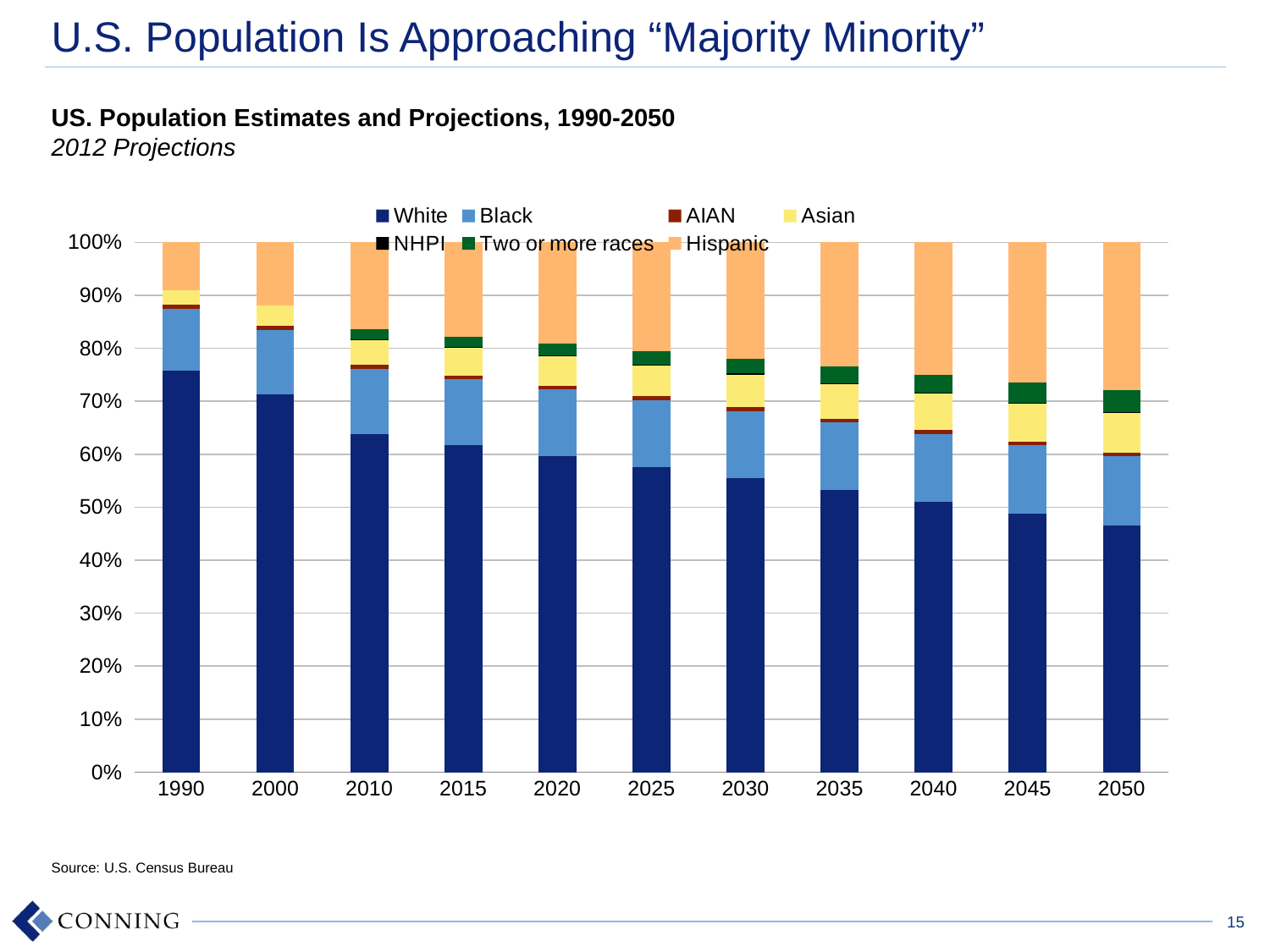
In which year is the White share of the population highest? 1990 Does the White share of the population rise or fall from 1990 to 2050? Fall In which year is the White share of the population lowest? 2050 Is the White share of the population in 2050 greater or less than 50%? less Which is larger, the Hispanic share in 1990 or the Hispanic share in 2050? 2050 How many series does the chart's legend list? 7 What is the title of the chart? US. Population Estimates and Projections, 1990-2050 How many years are shown along the x axis of the chart? 11 Is the White share of the population in 2010 greater or less than 60%? greater What kind of chart is shown on the slide? Stacked bar chart Is the White share of the population in 1990 greater or less than 70%? greater What is the total of the stacked bar for 2020? 100%